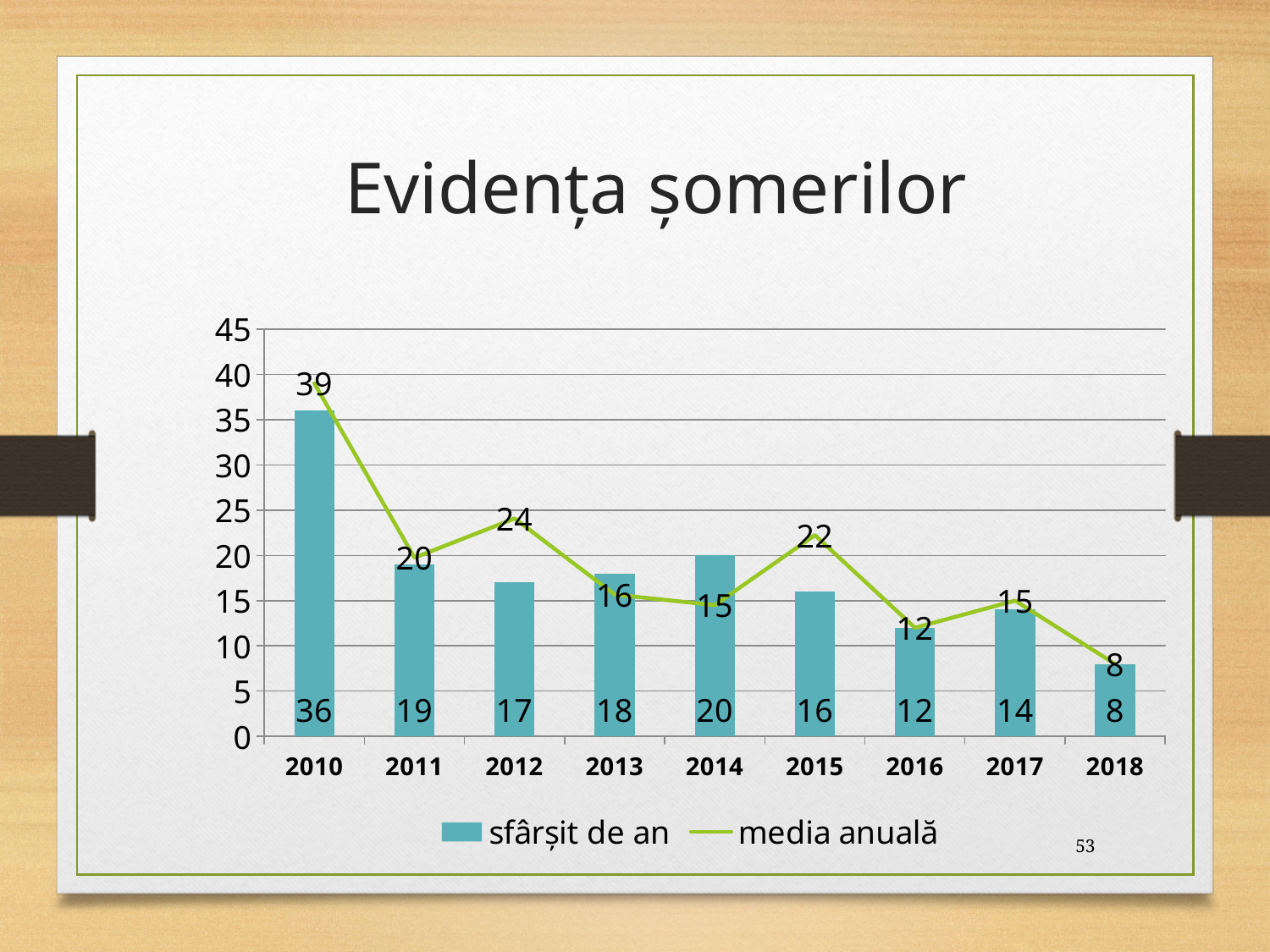
What is the difference between the "sfârșit de an" values for 2010 and 2011? 17 Which year has the highest "media anuală" value? 2010 How many years are shown on the x axis? 9 Which year has the lowest "sfârșit de an" value? 2018 What is the value of "sfârșit de an" for 2014? 20 Which is larger, the "sfârșit de an" value for 2013 or for 2015? 2013 How many series does the legend list? 2 What is the value of "sfârșit de an" for 2010? 36 What is the title of the slide? Evidența șomerilor What is the value of "media anuală" for 2012? 24 What kind of chart is shown on the slide? A combined bar and line chart What is the difference between the "media anuală" values for 2015 and 2016? 10